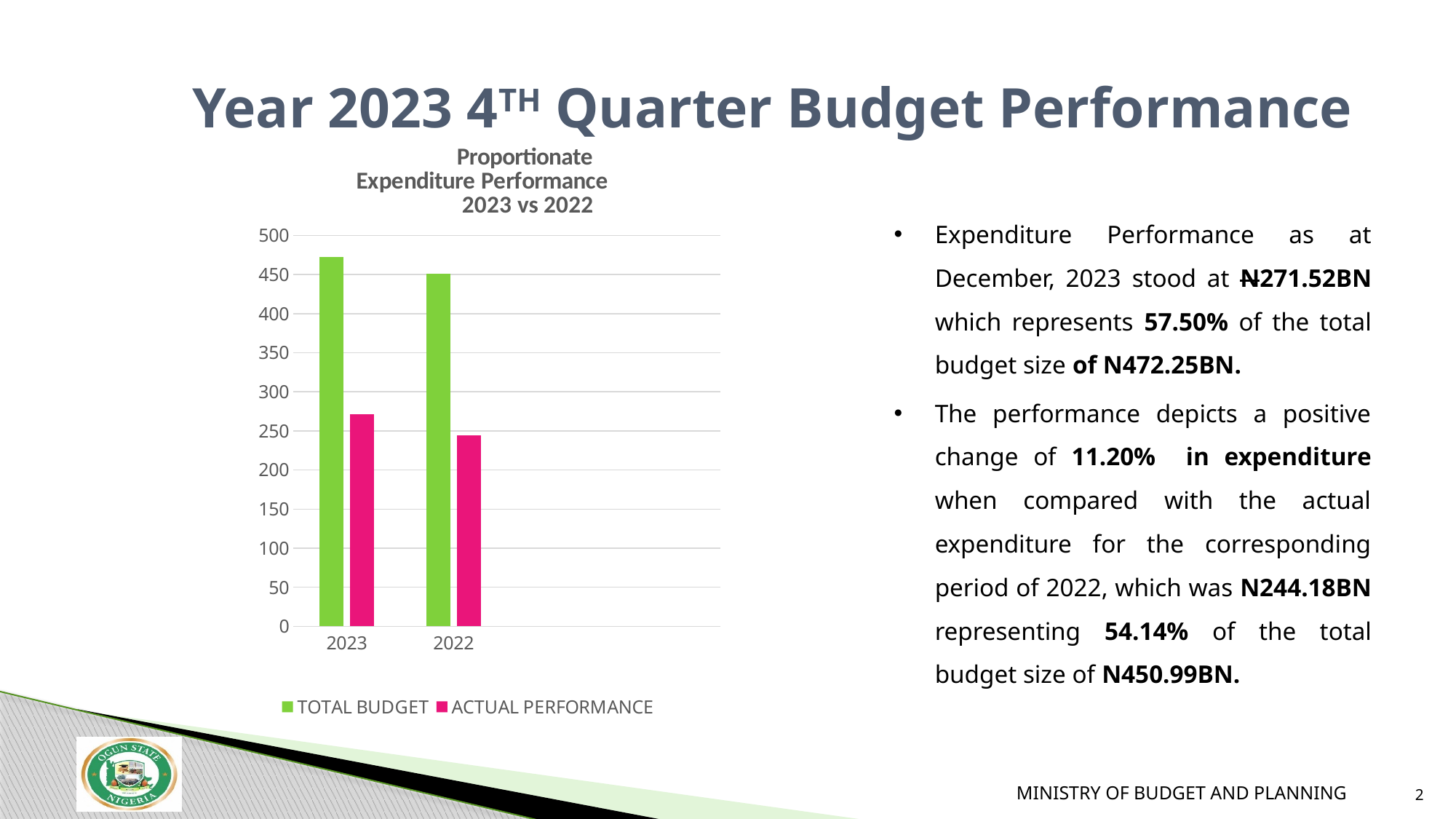
What colour are the ACTUAL PERFORMANCE bars in the chart? pink Which series has the tallest bar in the chart? TOTAL BUDGET What type of chart is shown on the slide? bar chart Is the ACTUAL PERFORMANCE value for 2023 greater or less than 250? greater Is the TOTAL BUDGET value for 2023 greater or less than 450? greater Is the TOTAL BUDGET value for 2022 greater or less than 400? greater What is the title of the chart? Proportionate Expenditure Performance 2023 vs 2022 Which year has the taller TOTAL BUDGET bar, 2023 or 2022? 2023 How many series does the chart legend list? 2 How many year categories are shown on the x axis of the chart? 2 Which year has the higher ACTUAL PERFORMANCE bar, 2023 or 2022? 2023